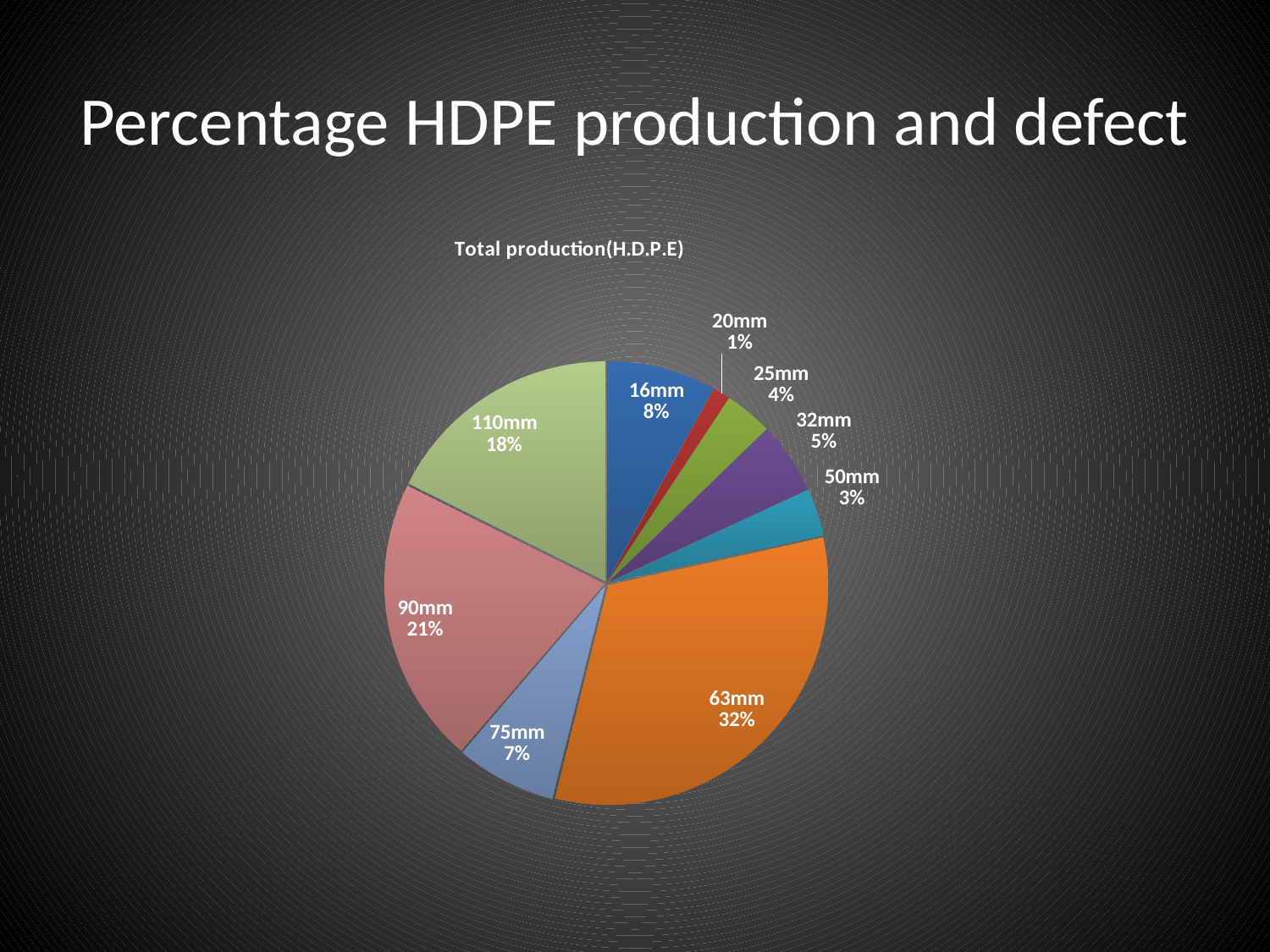
What percentage is shown for the 90mm category? 21% Which category has the smallest share of the pie? 20mm How many categories are shown in the pie chart? 9 What is the combined percentage of the 25mm and 32mm slices? 9% What is the title of the chart? Total production(H.D.P.E) What is the difference in percentage points between the 63mm and 90mm slices? 11 What percentage is shown for the 110mm category? 18% Which slice is larger, 16mm or 75mm? 16mm What percentage is shown for the 50mm category? 3% Which category has the largest share of the pie? 63mm What kind of chart is shown on the slide? Pie chart What share of the pie does the 63mm slice represent? 32%